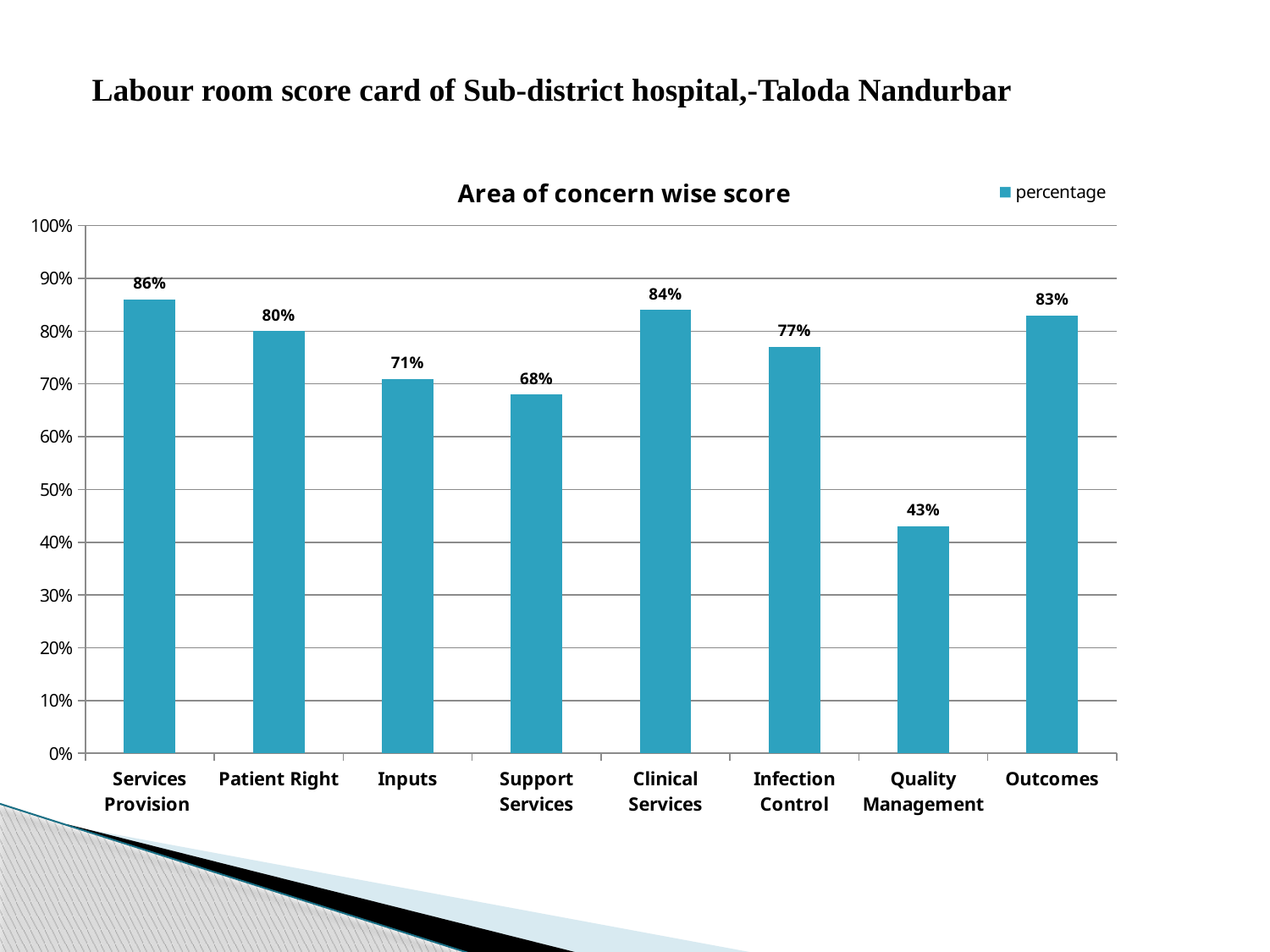
Which is larger, the value for Patient Right or the value for Inputs? Patient Right How many categories are shown on the x axis? 8 What is the value for Quality Management? 43% What is the difference between the values for Clinical Services and Support Services? 16% What is the value for Services Provision? 86% What is the value for Infection Control? 77% Is the value for Outcomes greater or less than 80%? greater What kind of chart is shown? bar chart What is the title of the chart? Area of concern wise score How many series does the legend list? 1 Which category has the lowest value? Quality Management Which category has the highest value? Services Provision